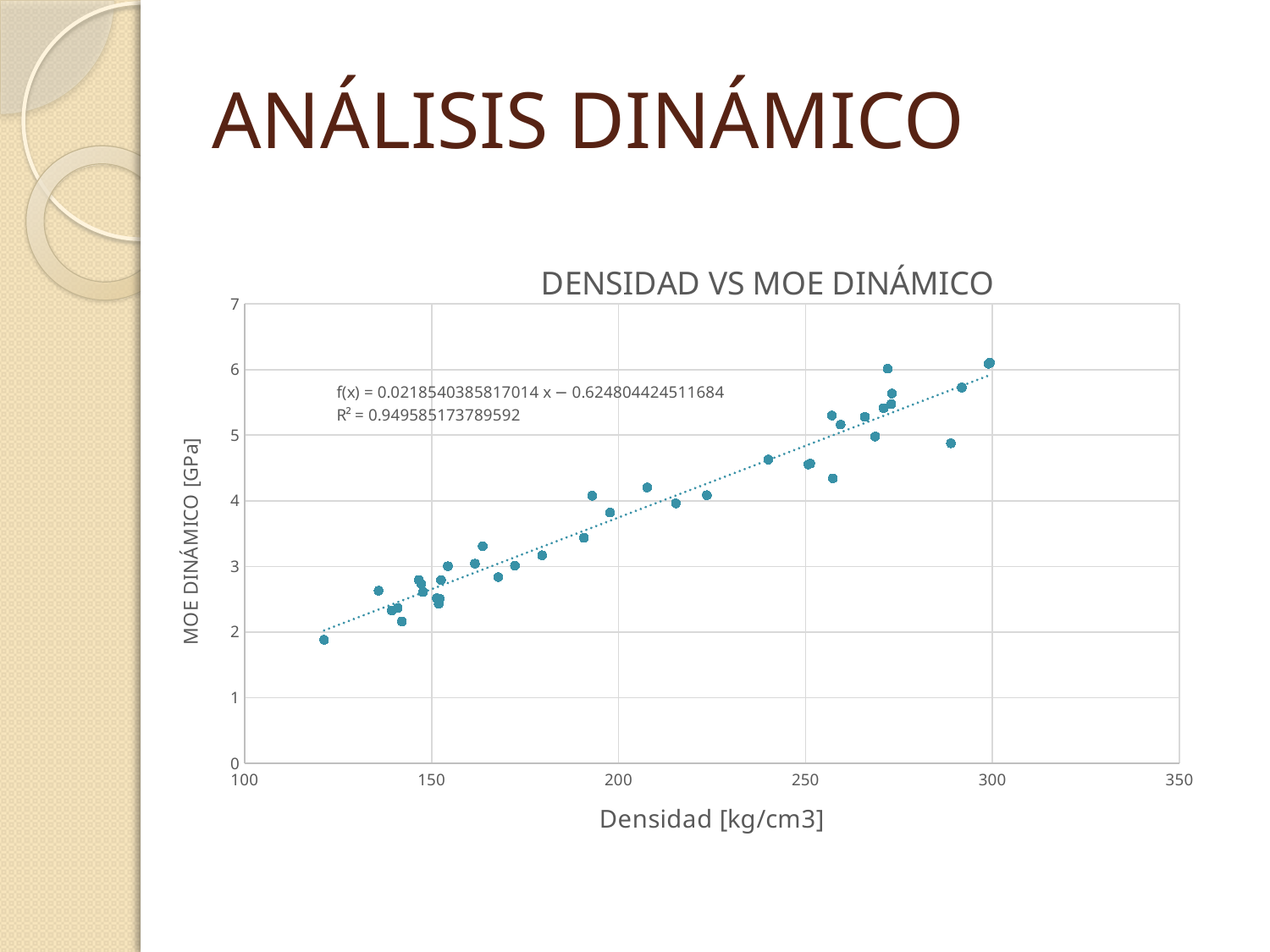
Is the MOE DINÁMICO value for the point at a density of about 289 kg/cm3 greater or less than 5? less What is the label of the x axis of the chart? Densidad [kg/cm3] Do the MOE DINÁMICO values rise or fall as Densidad increases along the x axis? Rise What kind of chart is shown on the slide? Scatter plot Is the MOE DINÁMICO value for the point at a density of about 240 kg/cm3 greater or less than 5? less What is the maximum value shown on the y axis of the chart? 7 Is the MOE DINÁMICO value for the point at a density of about 240 kg/cm3 greater or less than 4? greater What is the title of the chart? DENSIDAD VS MOE DINÁMICO What R² value is printed on the chart for the trendline? R² = 0.949585173789592 What is the slope coefficient of x in the trendline equation printed on the chart? 0.0218540385817014 Which point has the highest MOE DINÁMICO value: the one at a density of about 300 kg/cm3 or the one at about 289 kg/cm3? The one at about 300 kg/cm3